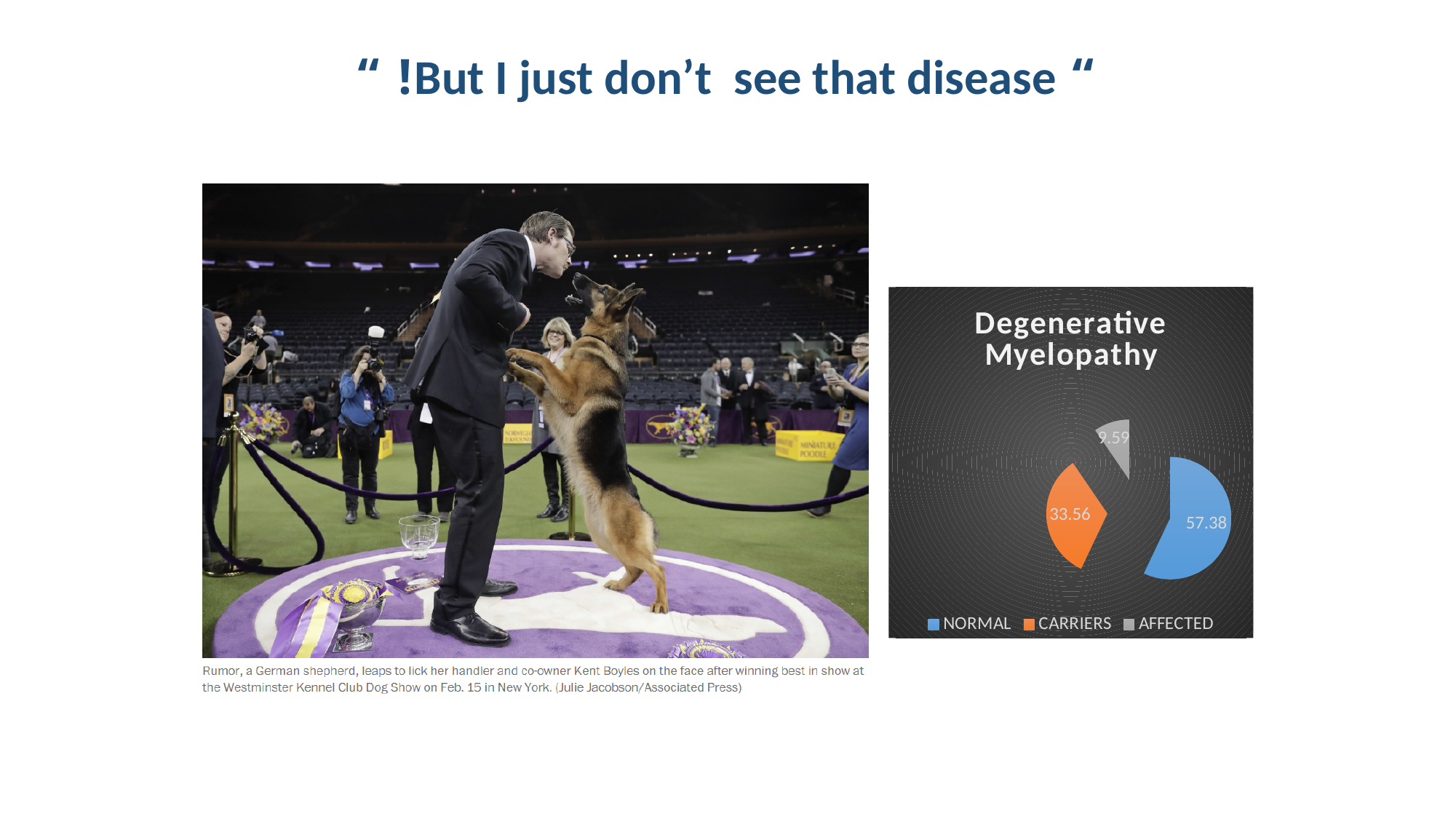
What value is shown for CARRIERS in the pie chart? 33.56 What is the difference between the CARRIERS and AFFECTED values? 23.97 Which colour represents CARRIERS in the pie chart? orange Which is larger, the value for CARRIERS or the value for AFFECTED? CARRIERS What value is shown for AFFECTED in the pie chart? 9.59 Which category has the smallest slice in the pie chart? AFFECTED What kind of chart is shown on the slide? pie chart How many slices does the pie chart have? 3 What value is shown for NORMAL in the pie chart? 57.38 What is the difference between the NORMAL and CARRIERS values? 23.82 Which category has the largest slice in the pie chart? NORMAL What is the title of the chart? Degenerative Myelopathy